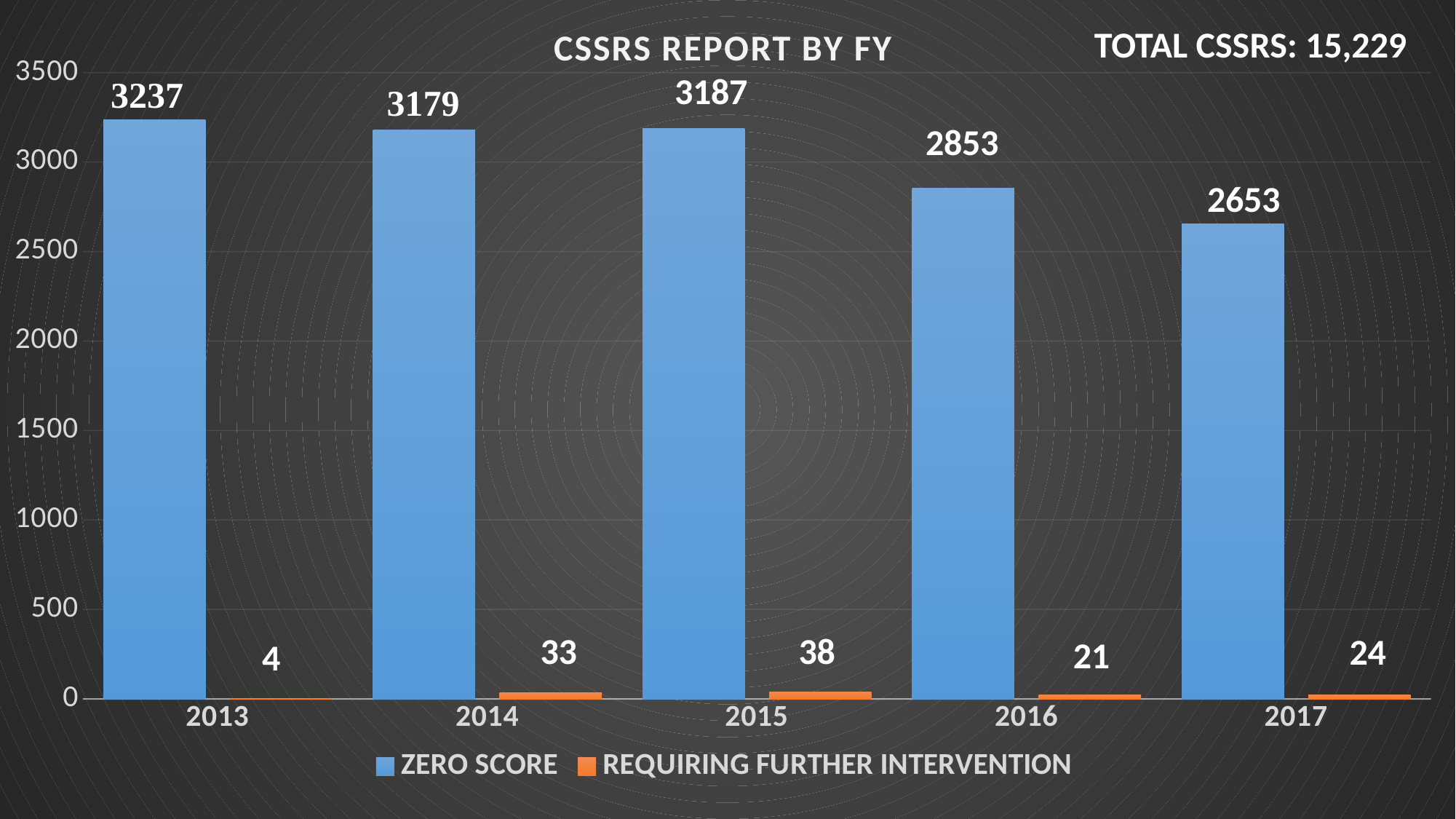
Which year has the lowest REQUIRING FURTHER INTERVENTION value? 2013 What kind of chart is shown? bar chart What is the ZERO SCORE value for 2017? 2653 What is the ZERO SCORE value for 2013? 3237 Which is larger, the REQUIRING FURTHER INTERVENTION value for 2014 or for 2016? 2014 How many series does the legend list? 2 Which year has the highest ZERO SCORE value? 2013 What is the difference between the ZERO SCORE values for 2016 and 2017? 200 What is the title of the chart? CSSRS REPORT BY FY Is the ZERO SCORE value for 2016 greater or less than 3000? less What is the REQUIRING FURTHER INTERVENTION value for 2015? 38 How many years are shown on the x axis? 5